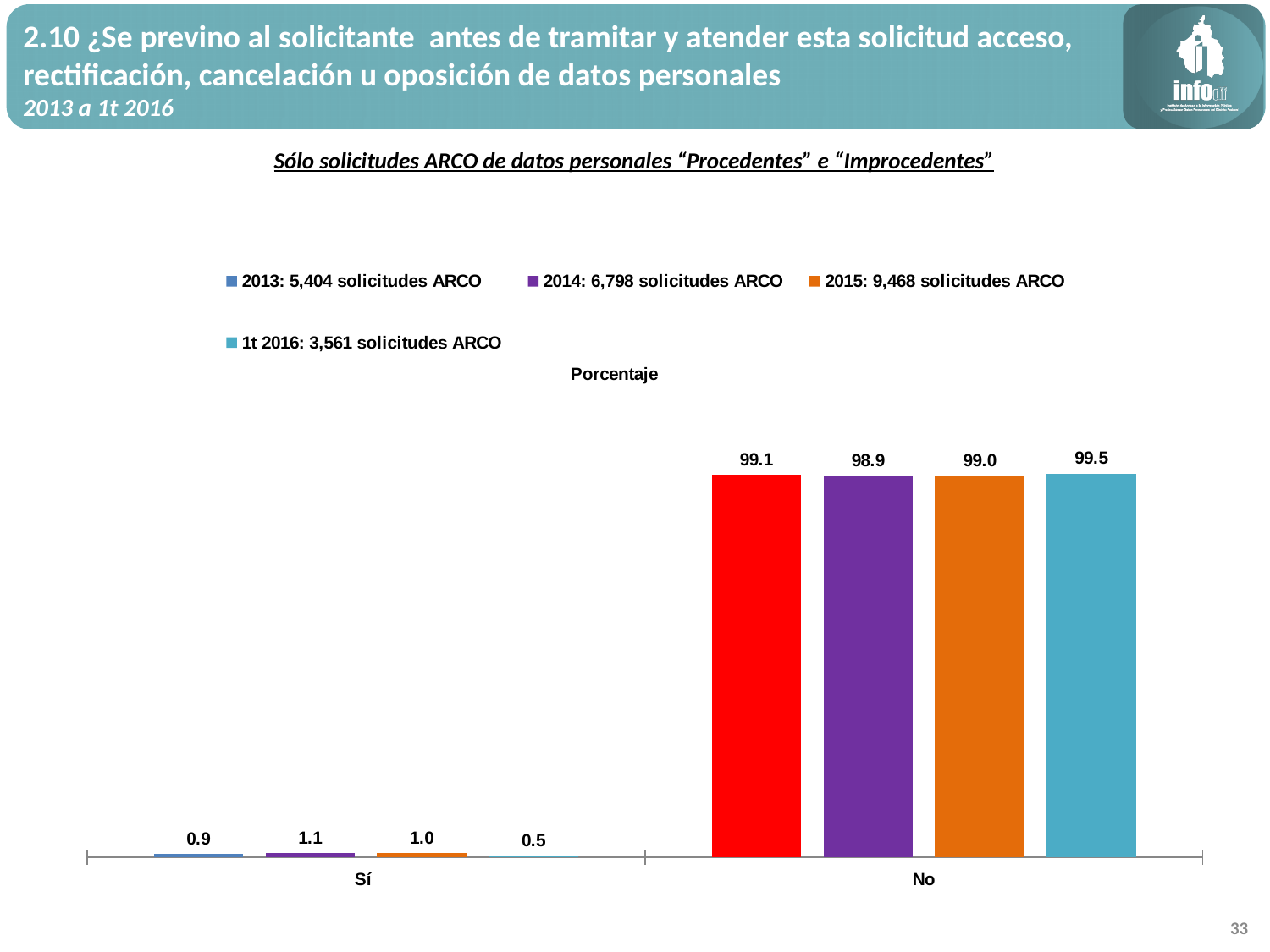
How many solicitudes ARCO does the legend give for 2015? 9,468 Which is larger: the 2013 value for "No" or the 2015 value for "No"? 2013 (99.1) What is the value for 2014 in the "No" category? 98.9 Which series has the lowest value in the "No" category? 2014: 6,798 solicitudes ARCO What is the value for 1t 2016 in the "No" category? 99.5 Which series has the highest value in the "Sí" category? 2014: 6,798 solicitudes ARCO What is the value for 2013 in the "Sí" category? 0.9 How many series does the legend list? 4 What is the difference between the 2014 and 1t 2016 values in the "Sí" category? 0.6 What kind of chart is shown on the slide? Bar chart How many categories are shown on the x axis? 2 What is the value for 2015 in the "Sí" category? 1.0